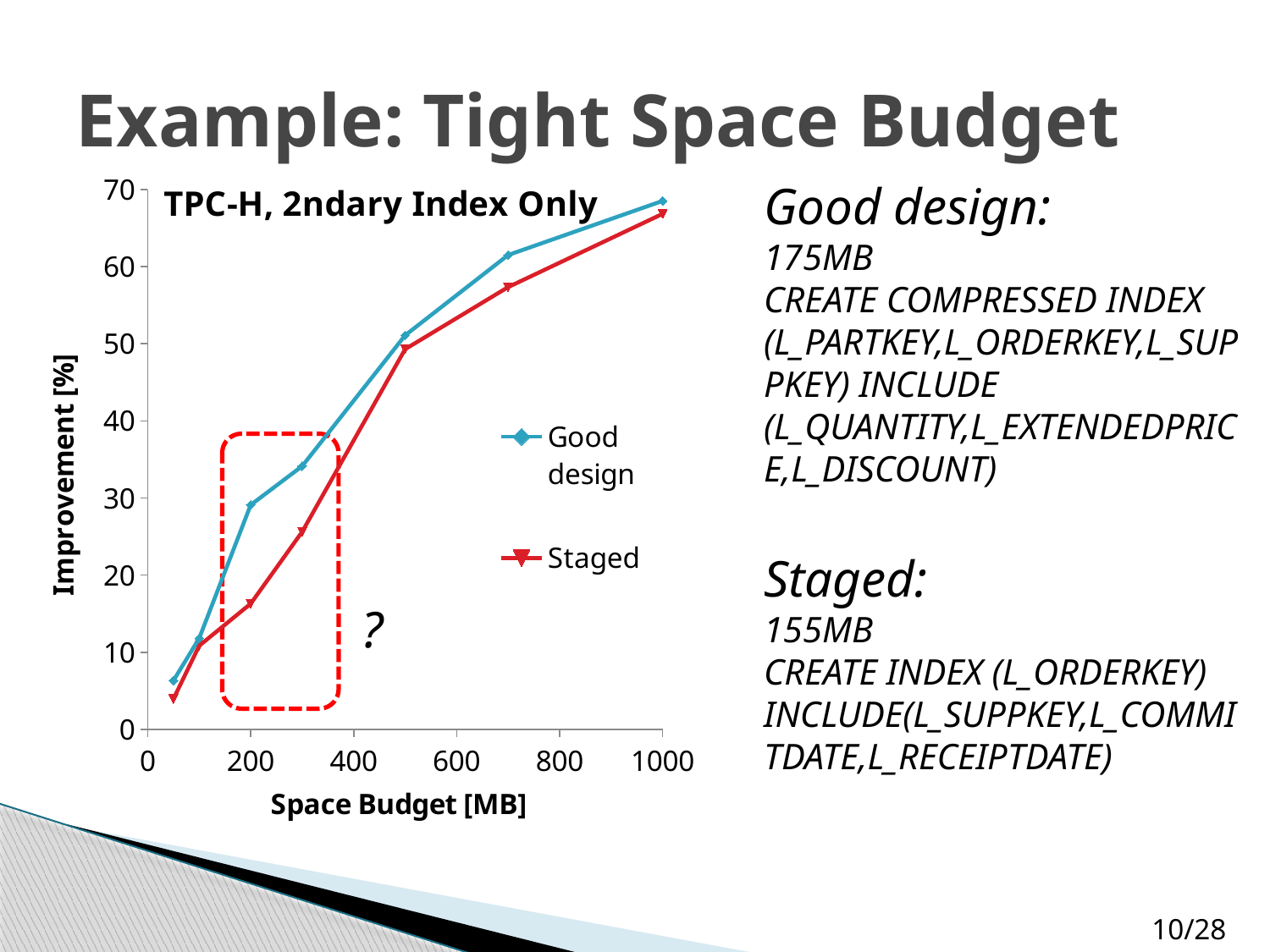
What is the label of the x axis? Space Budget [MB] Does the Staged series rise or fall as the space budget increases? rise What kind of chart is shown on the slide? line chart What is the title of the chart? TPC-H, 2ndary Index Only Is the Good design value at a space budget of 200 MB greater or less than 20? greater Is the Staged value at a space budget of 700 MB greater or less than 60? less Does the Good design series rise or fall as the space budget increases? rise How many series does the legend list? 2 At which space budget does the Good design series reach its highest improvement? 1000 Is the Good design value at a space budget of 300 MB greater or less than 30? greater At a space budget of 200 MB, which series has the higher improvement, Good design or Staged? Good design